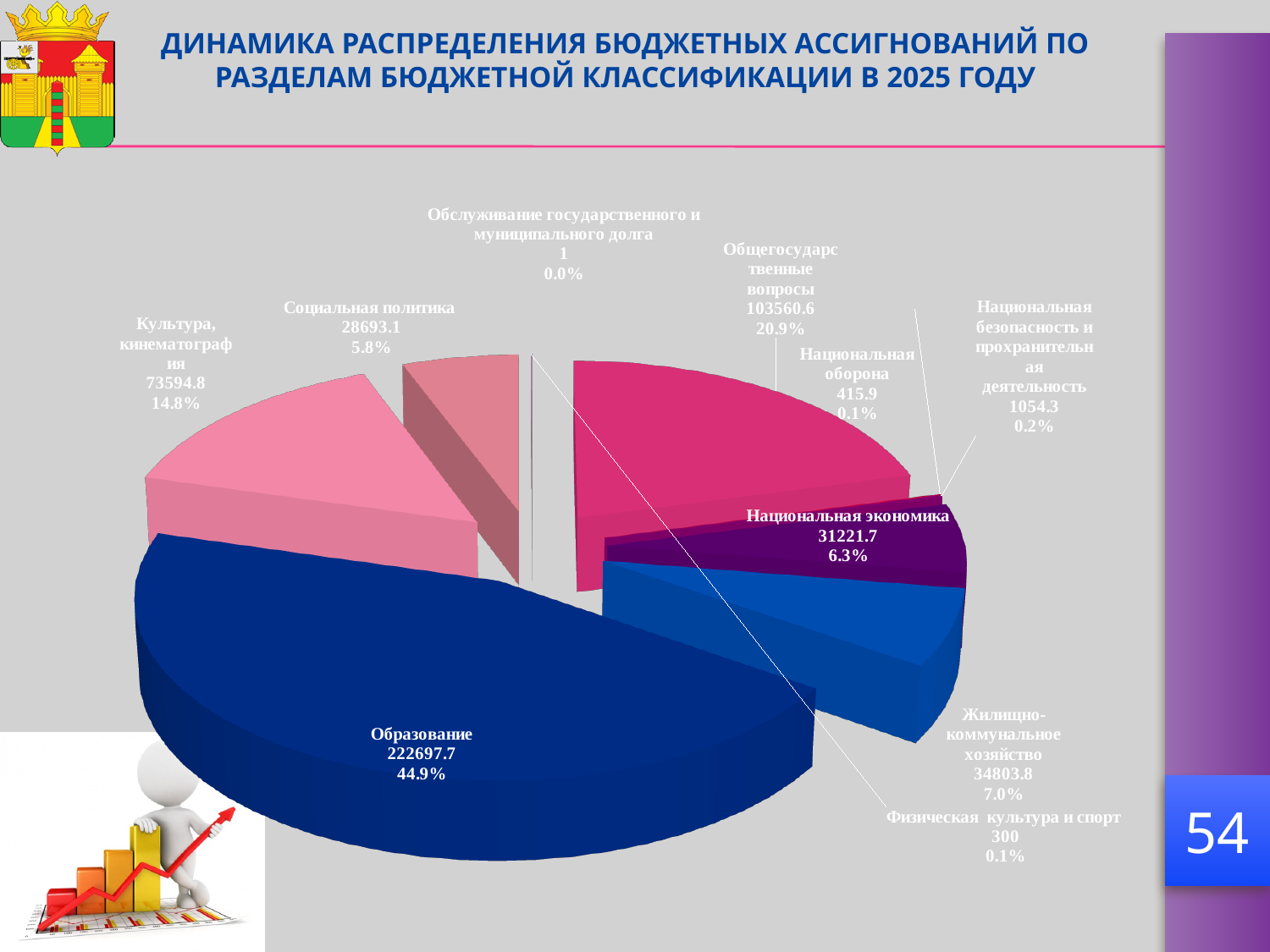
What type of chart is shown on the slide? Pie chart What percentage share does Национальная экономика have in the pie chart? 6.3% Which category has the largest slice of the pie chart? Образование What is the value shown for Жилищно-коммунальное хозяйство? 34803.8 Which category has the smallest value in the pie chart? Обслуживание государственного и муниципального долга How many categories are shown in the pie chart? 10 What percentage share does Культура, кинематография have in the pie chart? 14.8% What is the value shown for Общегосударственные вопросы? 103560.6 Which is larger: the value for Жилищно-коммунальное хозяйство or for Национальная экономика? Жилищно-коммунальное хозяйство What is the value shown for Образование? 222697.7 What is the difference between the values for Образование and Общегосударственные вопросы? 119137.1 What year does the chart title refer to? 2025